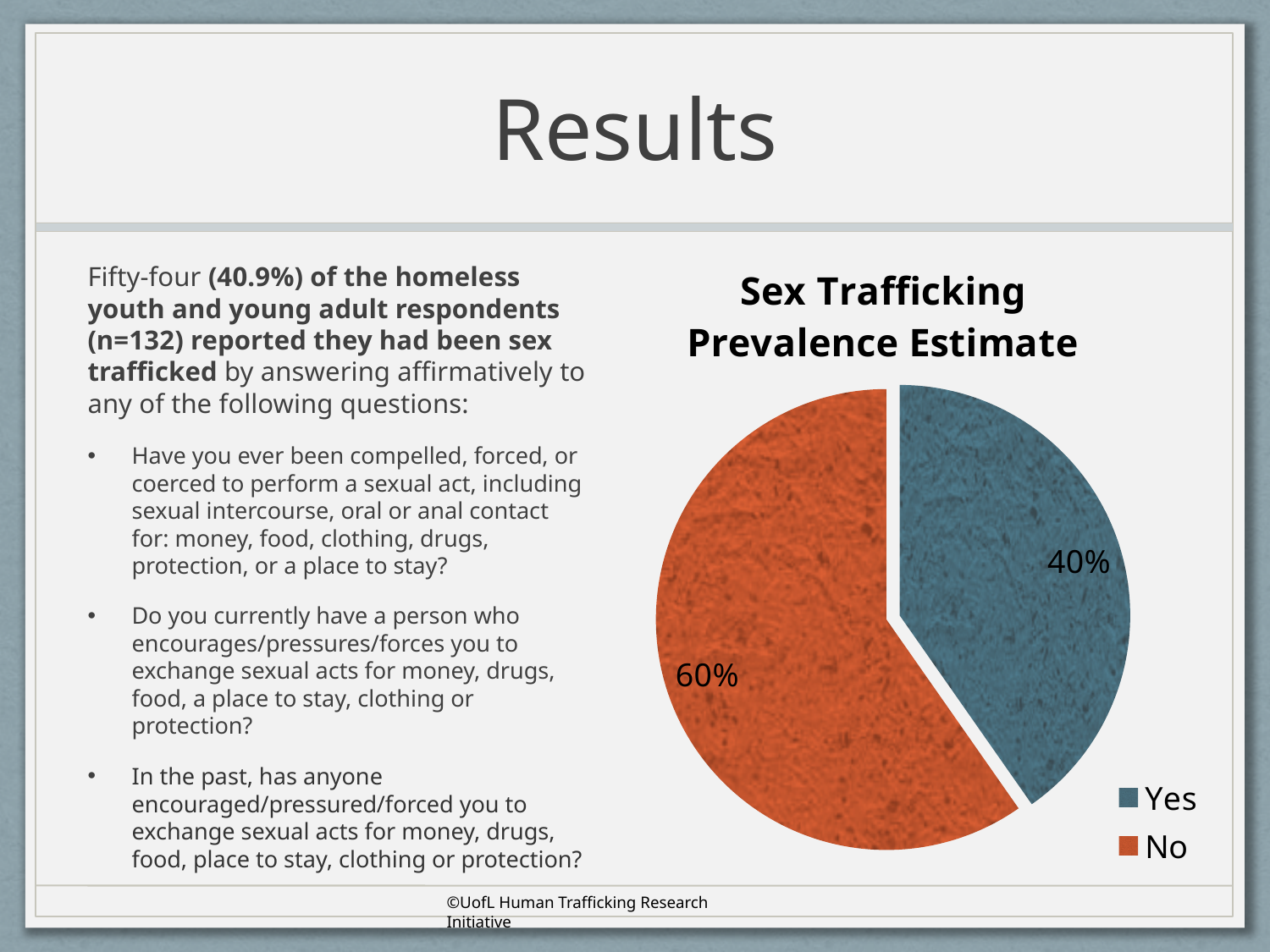
What percentage of the pie is labelled "No"? 60% What colour is the "No" slice in the pie chart? orange Which slice of the pie is the largest? No What share of the pie does the "Yes" slice represent? 40% Which is larger, the "Yes" slice or the "No" slice? No What is the difference in percentage points between the "No" slice and the "Yes" slice? 20% What is the title of the chart on the slide? Sex Trafficking Prevalence Estimate What percentage of the pie is labelled "Yes"? 40% Which slice of the pie is the smallest? Yes What kind of chart is shown on the slide? pie chart How many entries does the legend list? 2 How many slices does the pie chart have? 2